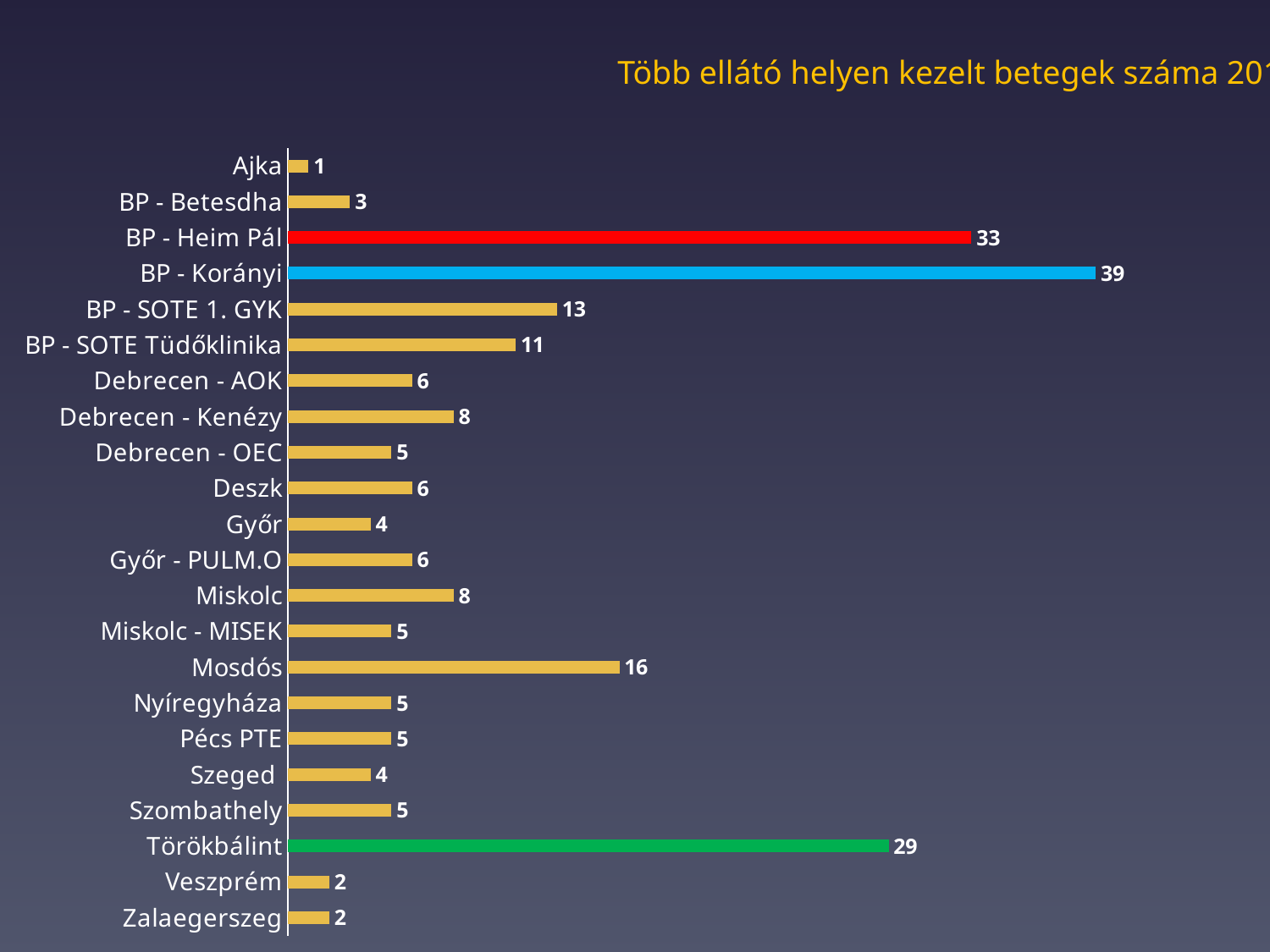
What is the value for Törökbálint? 29 What is the value for BP - Korányi? 39 What kind of chart is shown on the slide? Bar chart What is the value for Mosdós? 16 Which category has the lowest value? Ajka Which category has the highest value? BP - Korányi Which is larger, the value for Mosdós or the value for BP - SOTE 1. GYK? Mosdós Which category's bar is coloured green? Törökbálint What is the difference between the values for BP - Korányi and BP - Heim Pál? 6 What is the value for BP - SOTE Tüdőklinika? 11 What colour is the bar for BP - Heim Pál? Red How many categories are shown in the chart? 22